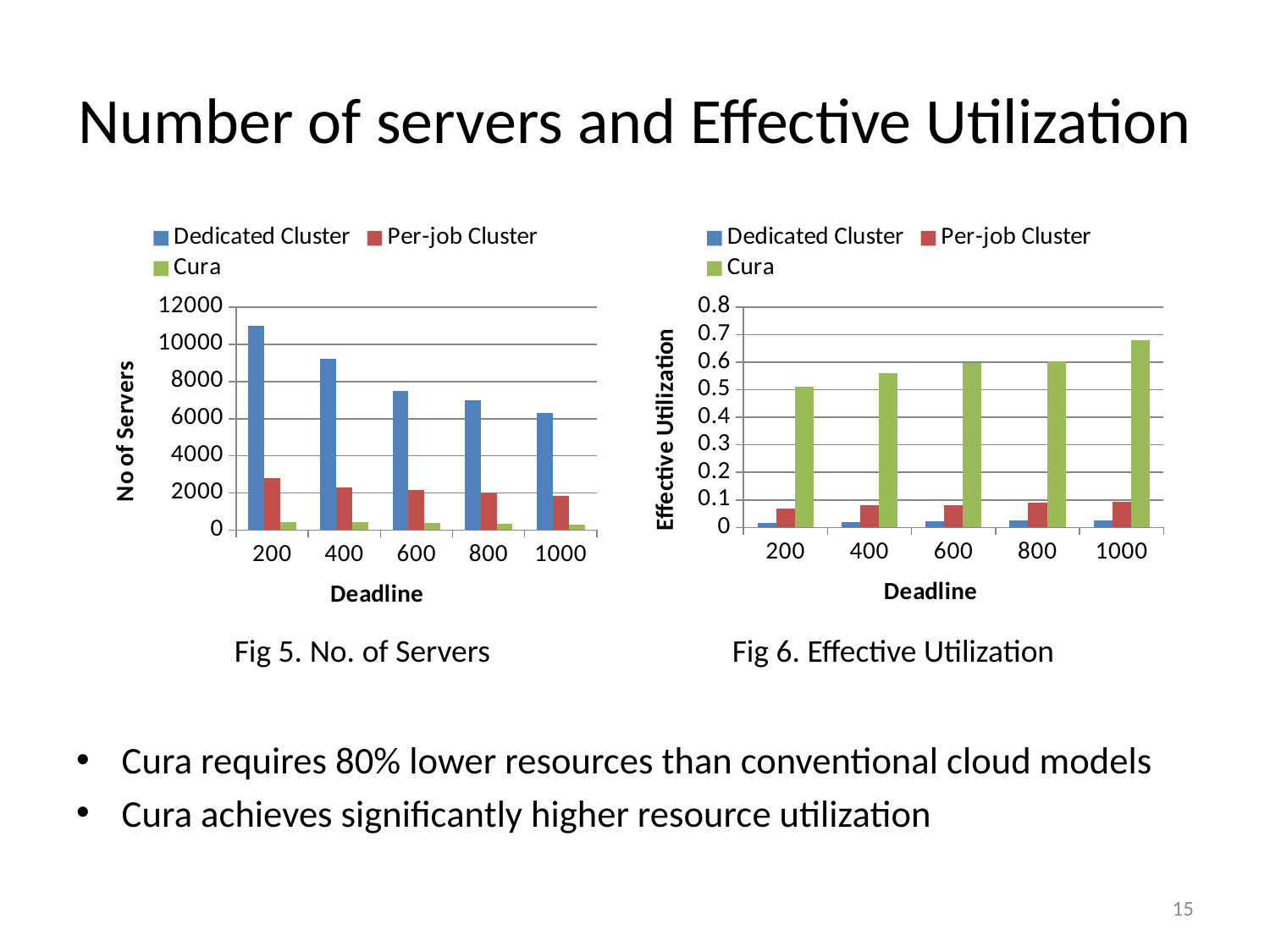
In Fig 6. Effective Utilization, which series has the lowest value at deadline 200? Dedicated Cluster In Fig 6. Effective Utilization, at which deadline is the Cura value highest? 1000 In Fig 5. No. of Servers, what kind of chart is shown? bar chart In Fig 6. Effective Utilization, is the Cura value at deadline 1000 greater or less than 0.6? greater In Fig 5. No. of Servers, at which deadline is the Dedicated Cluster value highest? 200 In Fig 5. No. of Servers, at deadline 200, which is larger: Per-job Cluster or Cura? Per-job Cluster In Fig 6. Effective Utilization, what is the title of the y axis? Effective Utilization In Fig 5. No. of Servers, how many series does the legend list? 3 In Fig 5. No. of Servers, how many deadline categories are shown on the x axis? 5 In Fig 5. No. of Servers, is the Dedicated Cluster value at deadline 200 greater or less than 10000? greater In Fig 5. No. of Servers, is the Dedicated Cluster value at deadline 1000 greater or less than 8000? less In Fig 5. No. of Servers, does the Dedicated Cluster value rise or fall as the deadline increases? fall